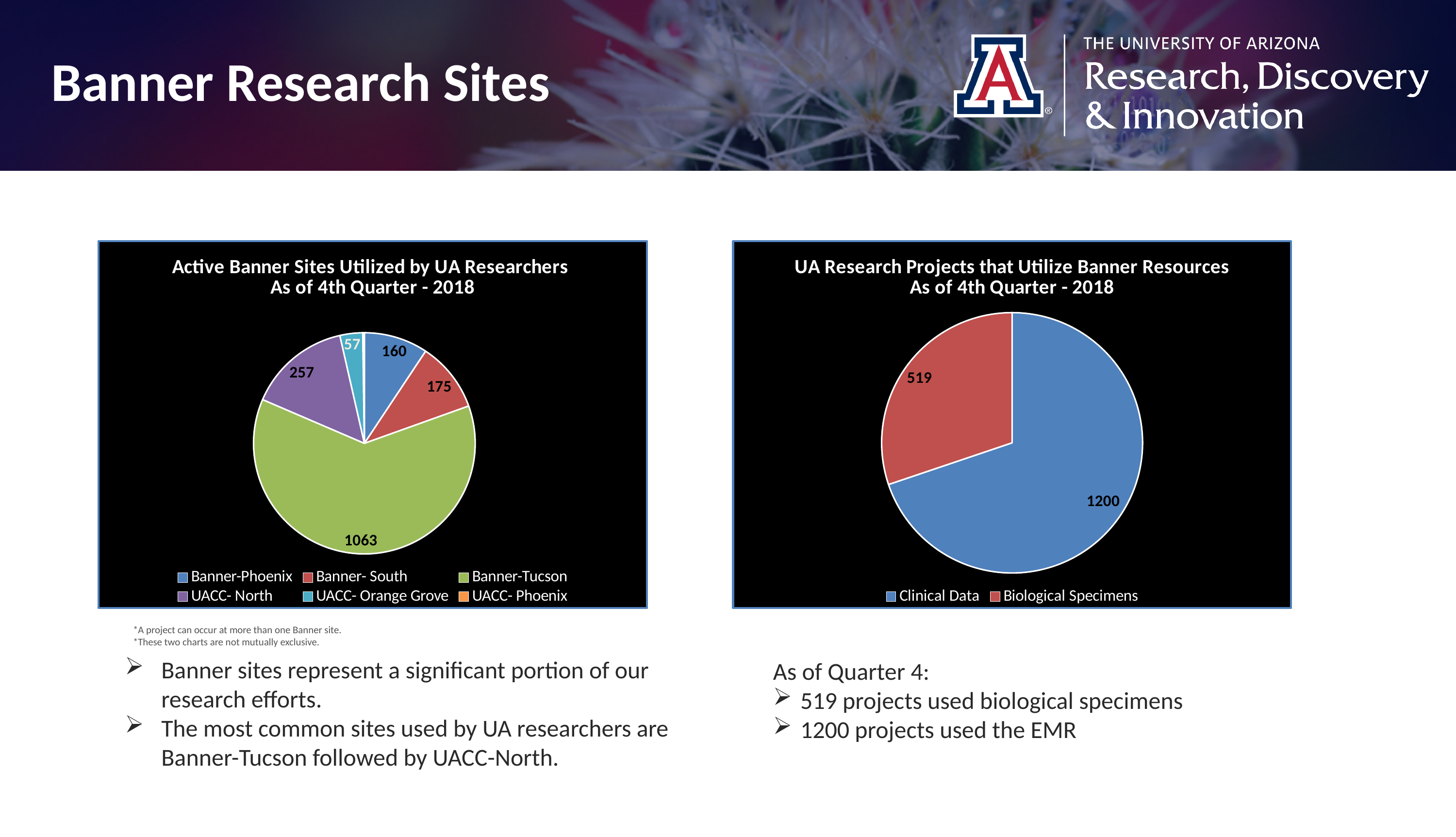
In the chart titled 'UA Research Projects that Utilize Banner Resources', what is the value for Biological Specimens? 519 In the chart titled 'Active Banner Sites Utilized by UA Researchers', what is the value for UACC- North? 257 In the chart titled 'Active Banner Sites Utilized by UA Researchers', what is the difference between the Banner-Tucson and UACC- North values? 806 In the chart titled 'Active Banner Sites Utilized by UA Researchers', how many entries does the legend list? 6 In the chart titled 'Active Banner Sites Utilized by UA Researchers', which site has the largest slice? Banner-Tucson In the chart titled 'Active Banner Sites Utilized by UA Researchers', which labelled slice is the smallest? UACC- Orange Grove In the chart titled 'UA Research Projects that Utilize Banner Resources', what is the value for Clinical Data? 1200 In the chart titled 'Active Banner Sites Utilized by UA Researchers', what is the value for UACC- Orange Grove? 57 In the chart titled 'UA Research Projects that Utilize Banner Resources', what is the difference between the Clinical Data and Biological Specimens values? 681 What type of chart is the chart on the right of the slide? Pie chart In the chart titled 'Active Banner Sites Utilized by UA Researchers', what is the value for Banner-Tucson? 1063 In the chart titled 'Active Banner Sites Utilized by UA Researchers', which is larger, Banner- South or Banner-Phoenix? Banner- South